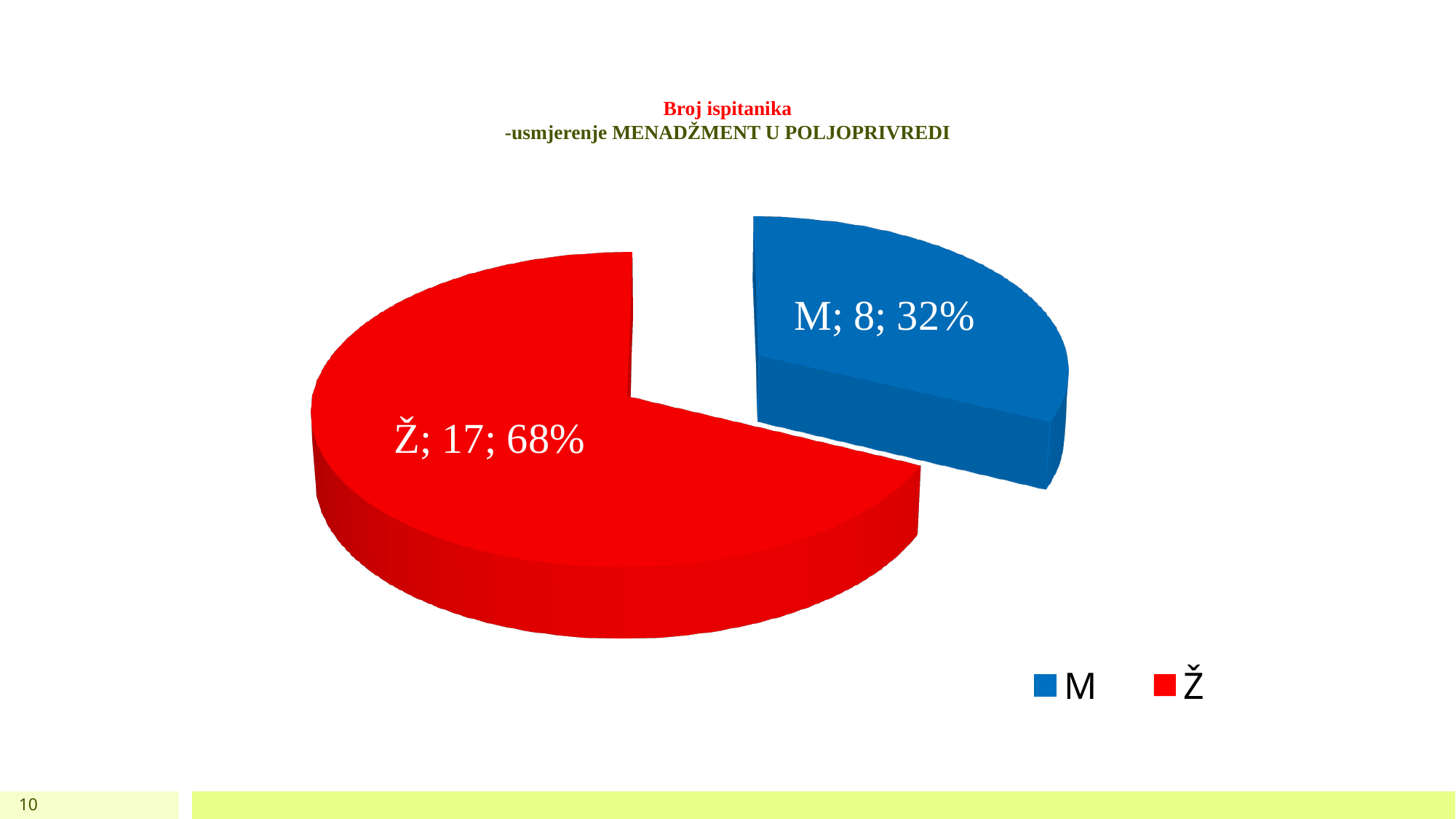
What is the difference between the number of Ž and M respondents? 9 How many respondents are in the Ž category? 17 How many categories does the pie chart have? 2 What colour is the Ž slice? red What kind of chart is shown on the slide? pie chart Which category has the smallest slice? M Which category has the largest slice? Ž Which category has more respondents, M or Ž? Ž What share of the pie does the M slice represent? 32% What share of the pie does the Ž slice represent? 68% What is the total number of respondents shown in the chart? 25 How many respondents are in the M category? 8